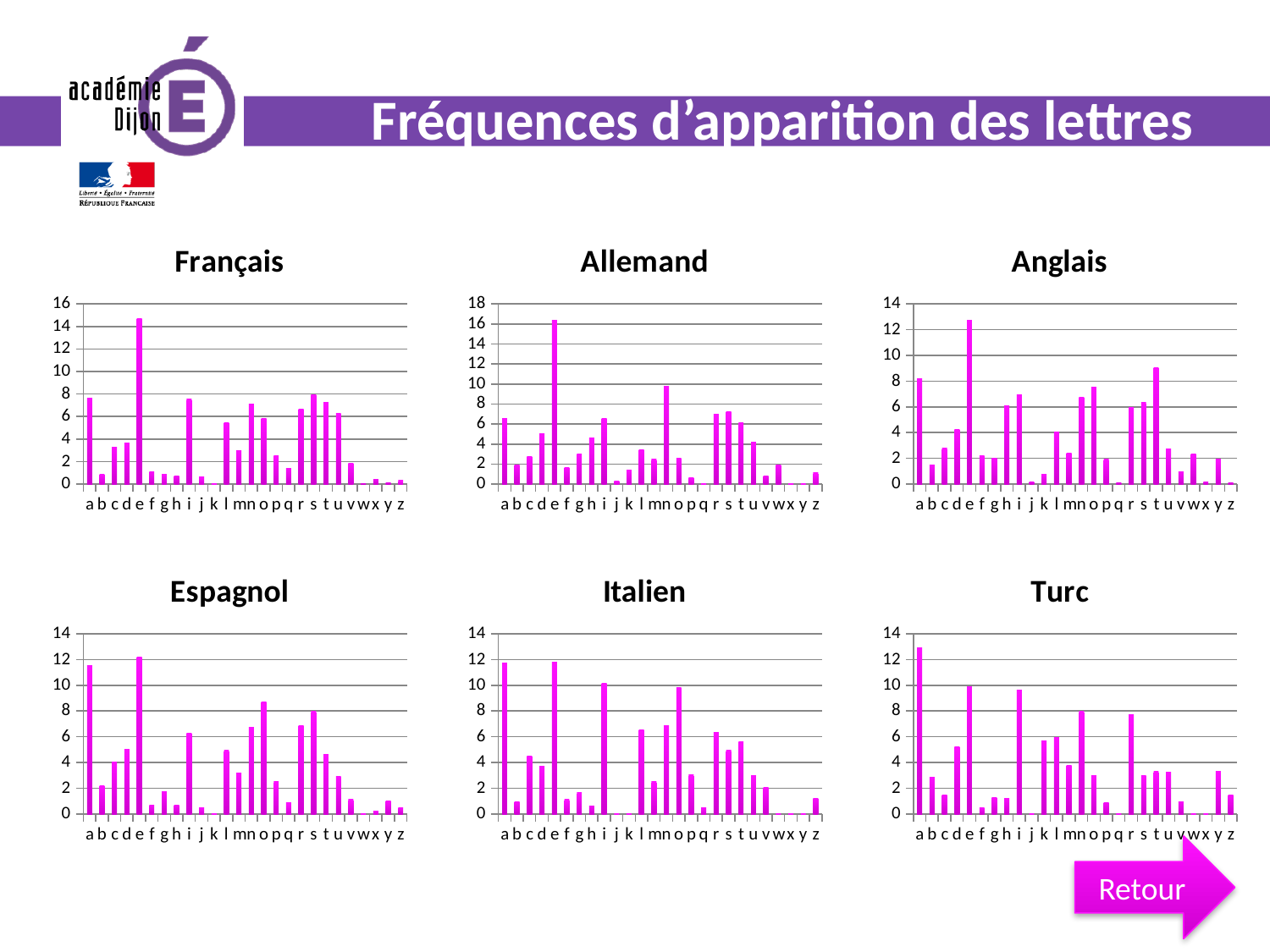
In the Allemand chart, is the value for n greater or less than 8? greater In the Italien chart, is the value for i greater or less than 8? greater What kind of chart is the Espagnol chart? bar chart In the Allemand chart, which letter has the highest frequency? e How many letters are shown on the x axis of the Turc chart? 26 In the Anglais chart, is the value for e greater or less than 12? greater In the Anglais chart, which letter has the highest frequency? e In the Turc chart, which letter has the highest frequency? a How many charts are shown on the slide? 6 In the Français chart, which is larger, the value for e or the value for a? e